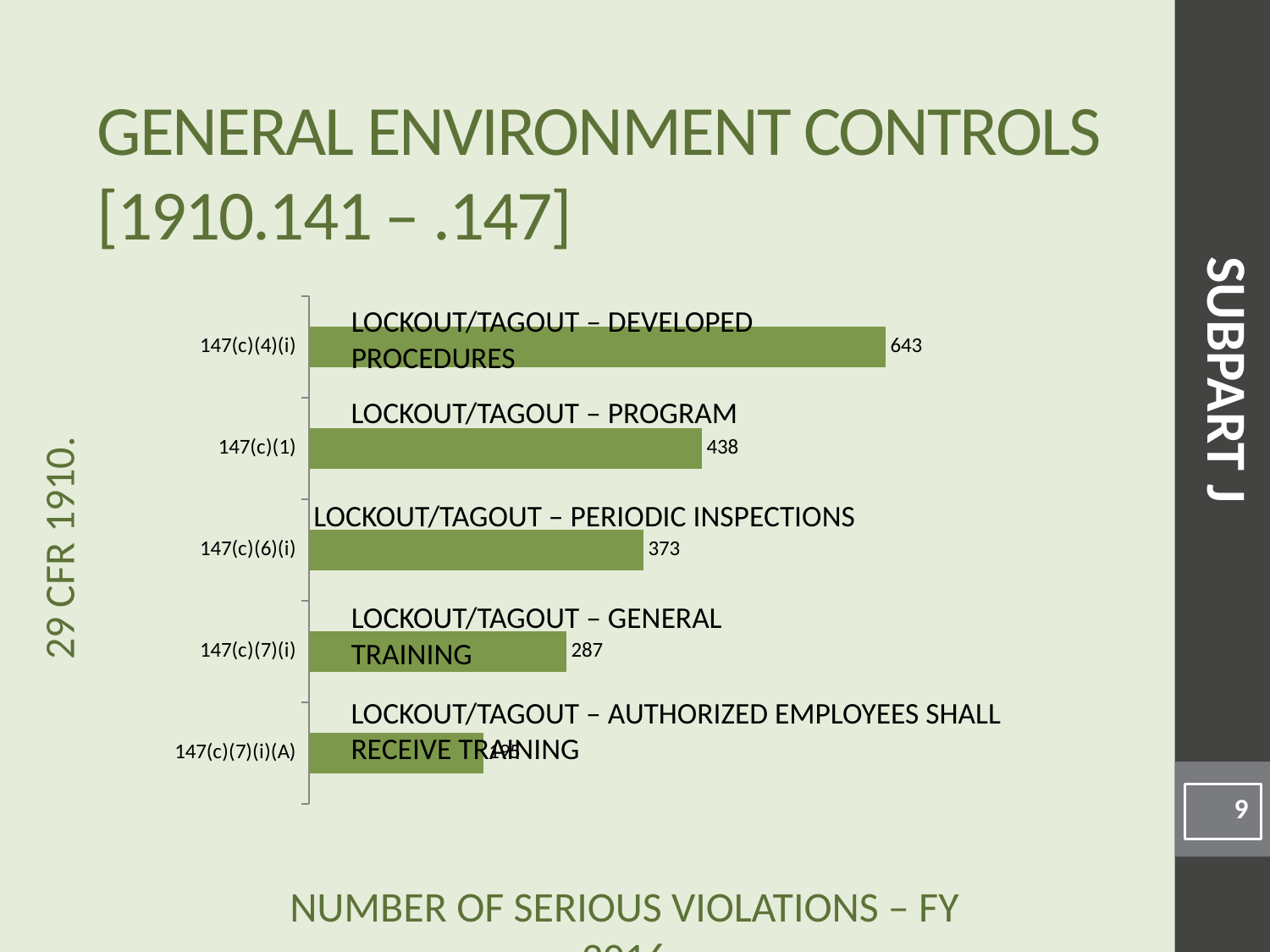
What description is written on the bar for 147(c)(1)? LOCKOUT/TAGOUT – PROGRAM How many serious violations are shown for 147(c)(6)(i)? 373 What type of chart is shown on the slide? Bar chart How many standards (bars) are shown in the chart? 5 What is the number of serious violations for 147(c)(4)(i)? 643 How much larger is the value for 147(c)(1) than the value for 147(c)(6)(i)? 65 What is the value for 147(c)(7)(i)? 287 Which has more serious violations, 147(c)(6)(i) or 147(c)(7)(i)? 147(c)(6)(i) What is the difference between the values for 147(c)(4)(i) and 147(c)(1)? 205 What value is shown for 147(c)(1)? 438 Which standard has the lowest number of serious violations? 147(c)(7)(i)(A) Which standard has the highest number of serious violations? 147(c)(4)(i)